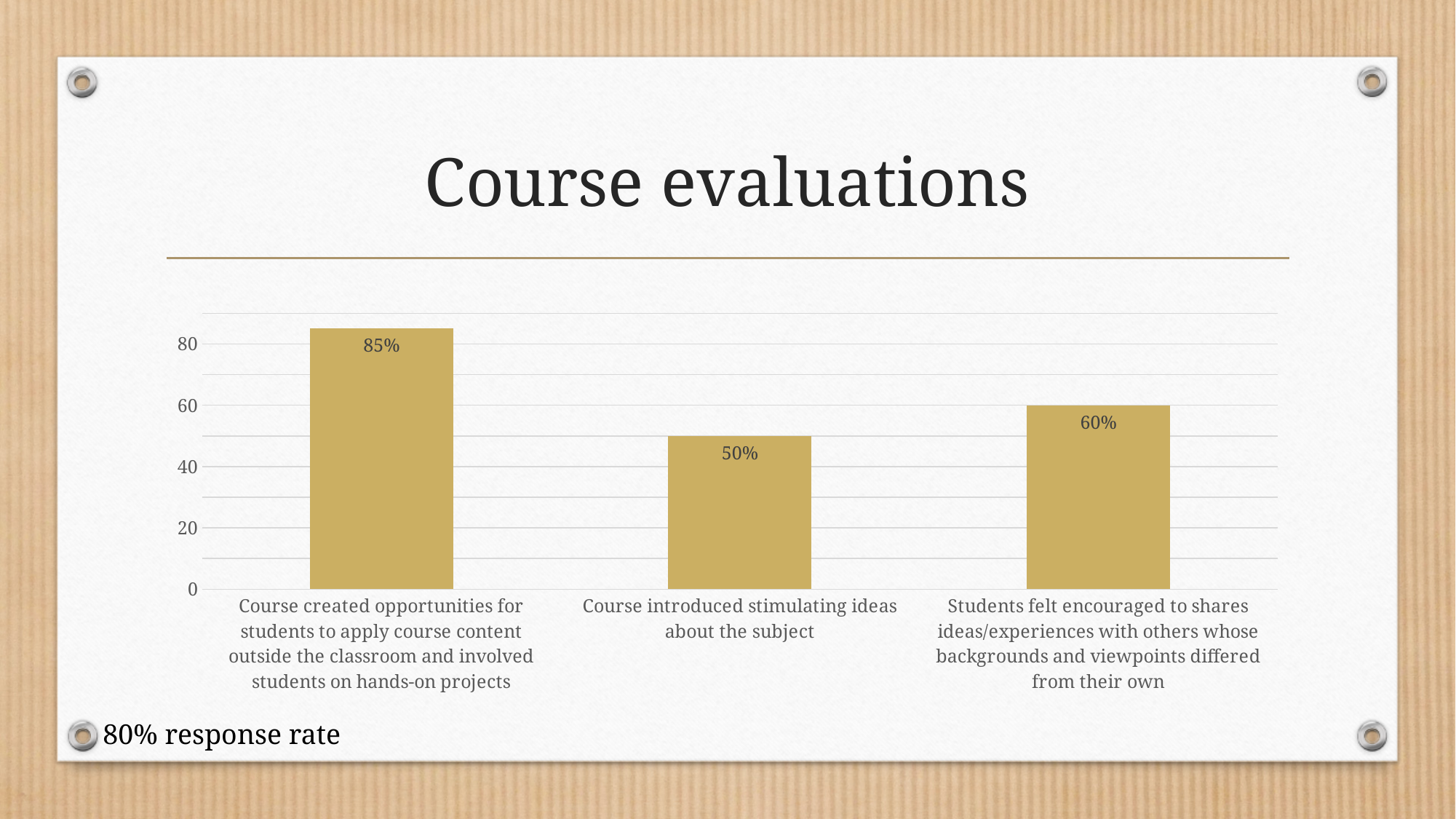
What is the difference between the highest and lowest values in the chart? 35% What is the difference between the values for "Students felt encouraged to shares ideas/experiences..." and "Course introduced stimulating ideas about the subject"? 10% What is the value for "Students felt encouraged to shares ideas/experiences with others whose backgrounds and viewpoints differed from their own"? 60% Which category has the highest value? Course created opportunities for students to apply course content outside the classroom and involved students on hands-on projects Is the value for "Course created opportunities for students to apply course content..." greater or less than 80? greater What is the title of the slide containing the chart? Course evaluations Which category has the lowest value? Course introduced stimulating ideas about the subject How many categories are shown in the chart? 3 Which is larger: the value for "Course introduced stimulating ideas about the subject" or the value for "Students felt encouraged to shares ideas/experiences..."? Students felt encouraged to shares ideas/experiences with others whose backgrounds and viewpoints differed from their own What kind of chart is shown on the slide? Bar chart What is the value for "Course created opportunities for students to apply course content outside the classroom and involved students on hands-on projects"? 85% What is the value for "Course introduced stimulating ideas about the subject"? 50%